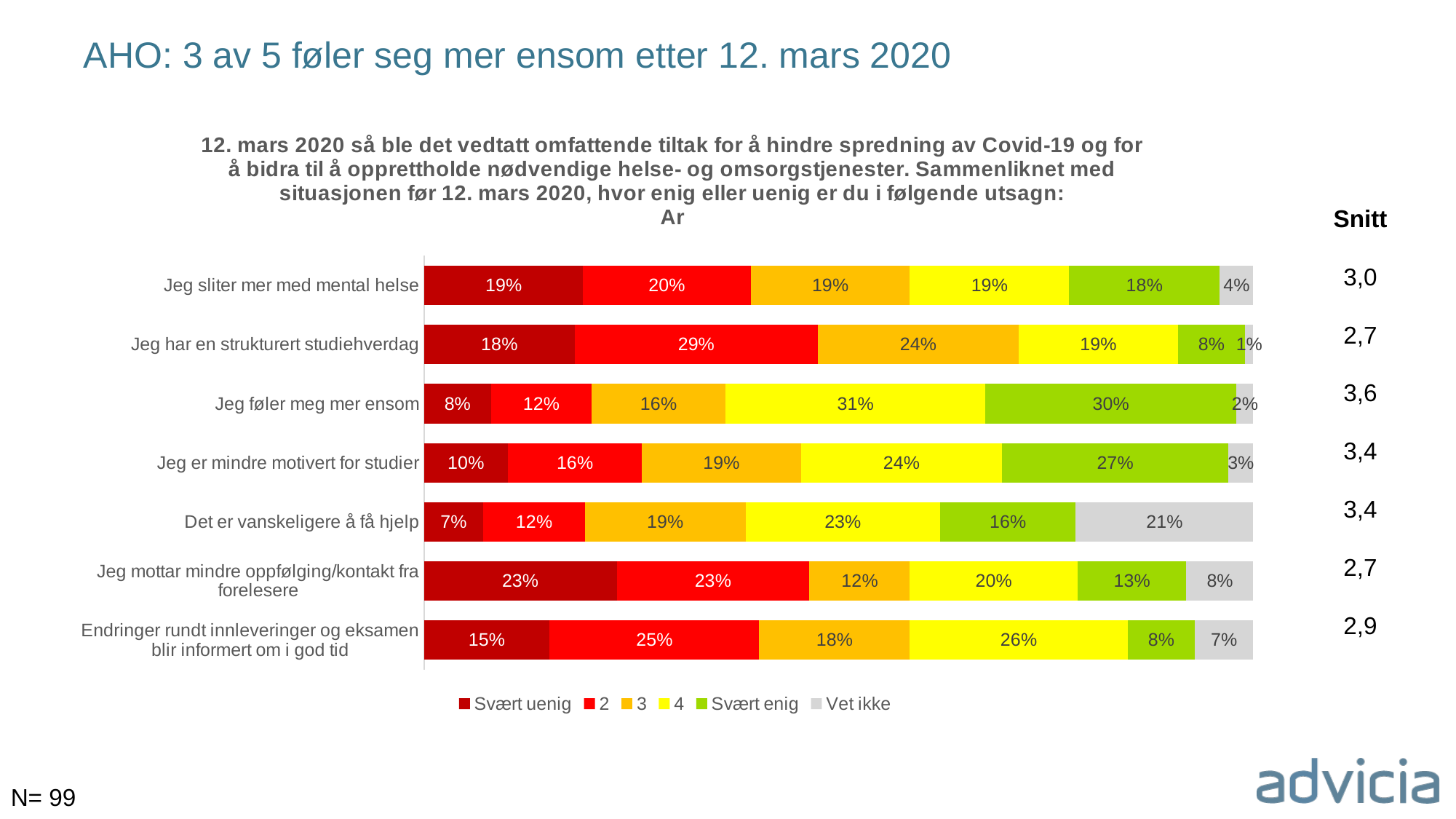
What percentage answered "2" for "Jeg har en strukturert studiehverdag"? 29% What is the first entry in the chart legend? Svært uenig Which statement has the lowest "Svært uenig" share? Det er vanskeligere å få hjelp Which statement has the highest "Svært enig" share? Jeg føler meg mer ensom What kind of chart is shown on the slide? Stacked bar chart How many statements are shown in the chart? 7 What is the difference between the "4" share and the "Svært uenig" share for "Jeg føler meg mer ensom"? 23% What percentage answered "Vet ikke" for "Det er vanskeligere å få hjelp"? 21% Which is larger for "Jeg mottar mindre oppfølging/kontakt fra forelesere": the "3" share or the "4" share? 4 What percentage answered "Svært enig" for "Jeg føler meg mer ensom"? 30% How many series does the legend list? 6 What is the "Snitt" value shown for "Jeg føler meg mer ensom"? 3,6